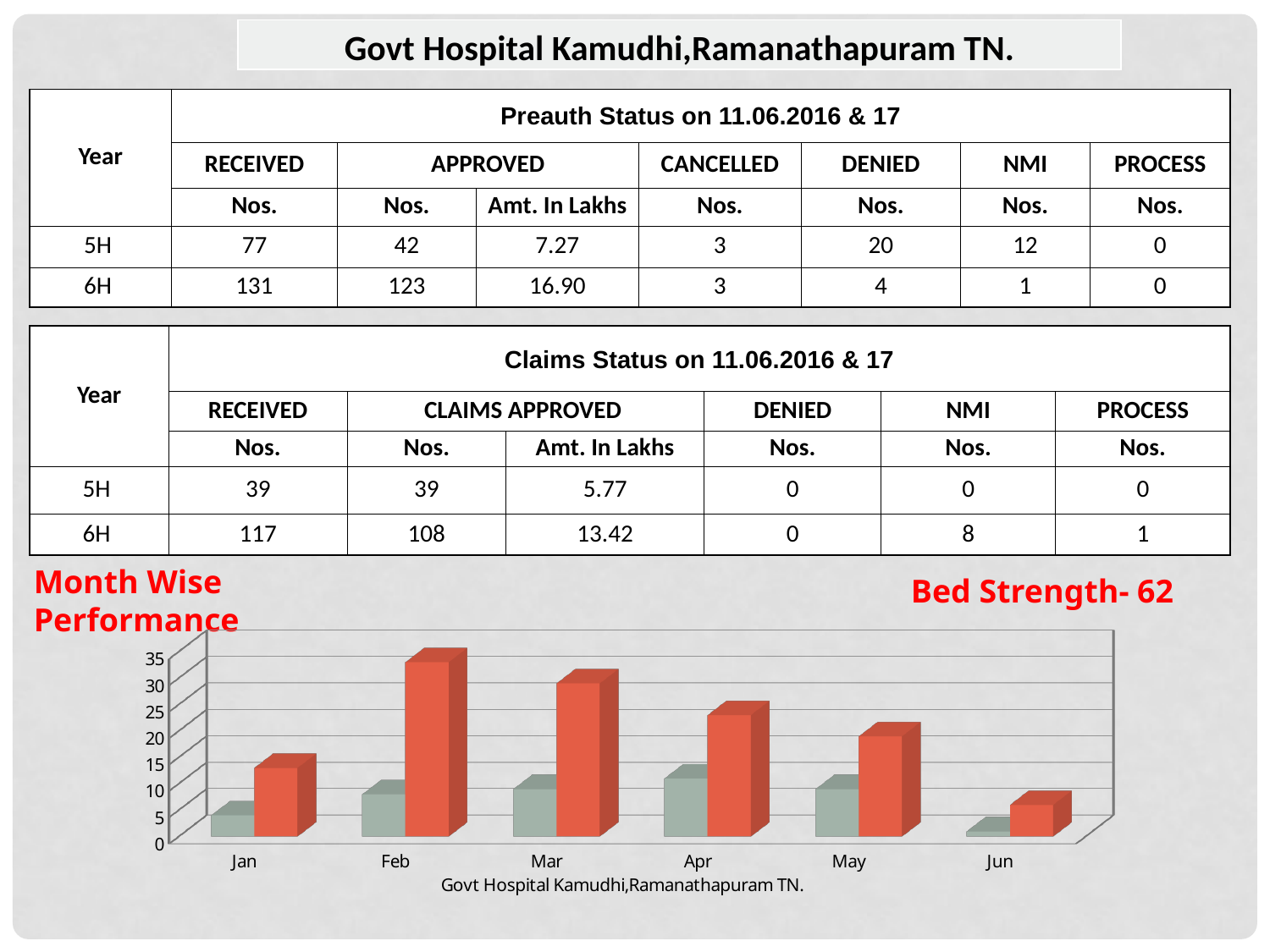
In the Month Wise Performance chart, is the red bar for Feb greater or less than 25? greater In the Month Wise Performance chart, is the red bar for Jun greater or less than 10? less What kind of chart is shown under 'Month Wise Performance'? bar chart In the Month Wise Performance chart, do the red bars rise or fall from Feb to Jun? fall How many months are shown on the x axis of the Month Wise Performance chart? 6 How many bars are plotted for each month in the Month Wise Performance chart? 2 What text appears below the x axis of the Month Wise Performance chart? Govt Hospital Kamudhi,Ramanathapuram TN. In the Month Wise Performance chart, is the red bar for Feb taller than the red bar for Mar? yes In the Month Wise Performance chart, which month has the tallest red bar? Feb In the Month Wise Performance chart, which is taller: the red bar for Mar or the red bar for Apr? Mar In the Month Wise Performance chart, which month has the shortest grey bar? Jun In the Month Wise Performance chart, which month has the shortest red bar? Jun